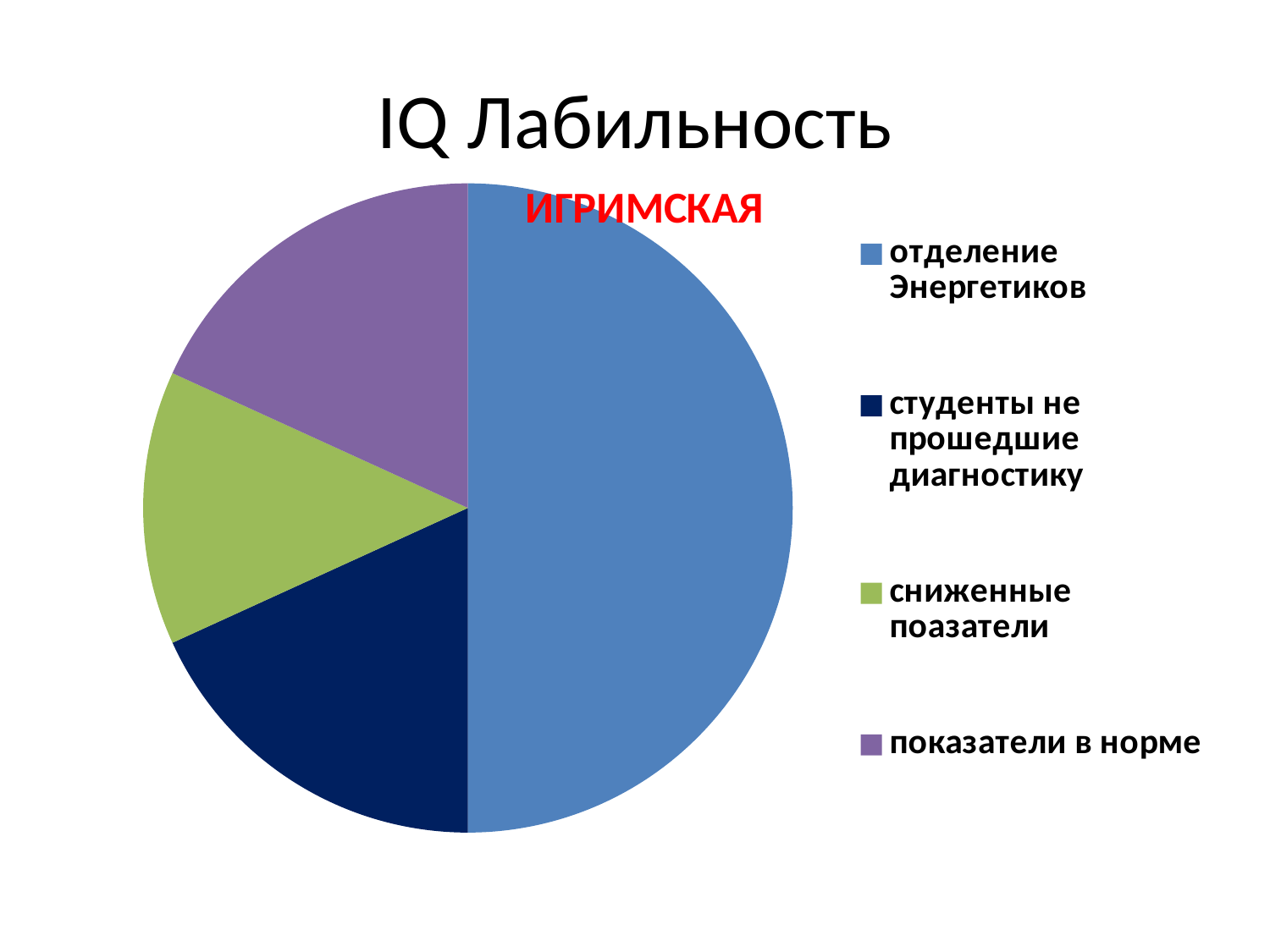
What colour is the slice for "показатели в норме"? purple Which slice is larger: "отделение Энергетиков" or "сниженные поазатели"? отделение Энергетиков What is the title of the slide? IQ Лабильность Which category has the largest slice of the pie? отделение Энергетиков Which slice is larger: "отделение Энергетиков" or "показатели в норме"? отделение Энергетиков Which slice is larger: "студенты не прошедшие диагностику" or "сниженные поазатели"? студенты не прошедшие диагностику Which category has the smallest slice of the pie? сниженные поазатели What kind of chart is shown on the slide? pie chart How many entries does the legend list? 4 How many slices does the pie chart have? 4